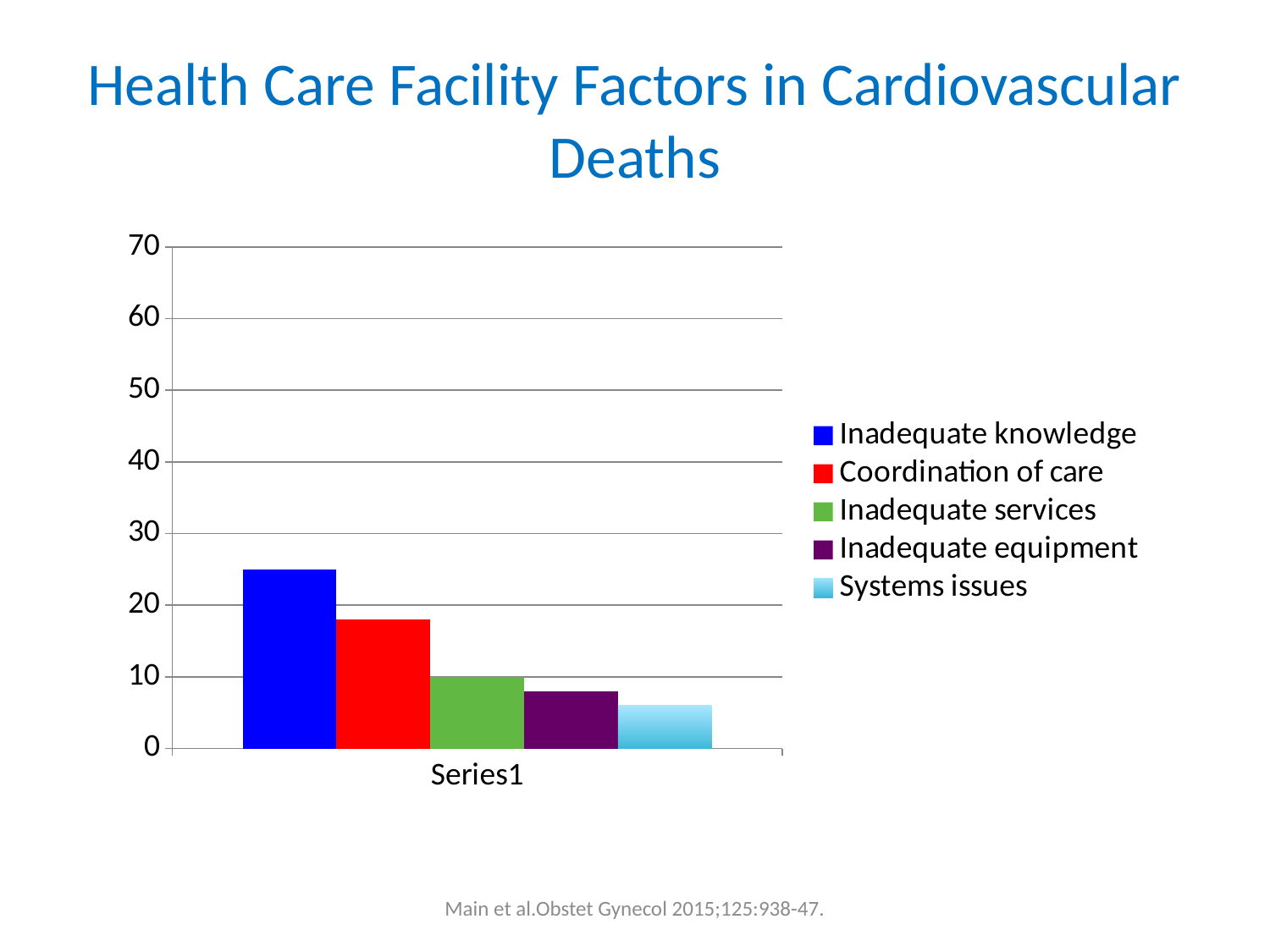
Do the bar values rise or fall from left to right across the chart? fall Is the value for Systems issues greater or less than 10? less Which is larger, the value for Inadequate knowledge or the value for Coordination of care? Inadequate knowledge What is the title of the chart on the slide? Health Care Facility Factors in Cardiovascular Deaths Is the value for Inadequate knowledge greater or less than 20? greater Is the value for Inadequate knowledge greater or less than 30? less Which factor has the lowest bar? Systems issues What kind of chart is shown on the slide? bar chart How many entries does the legend list? 5 Which factor has the highest bar? Inadequate knowledge